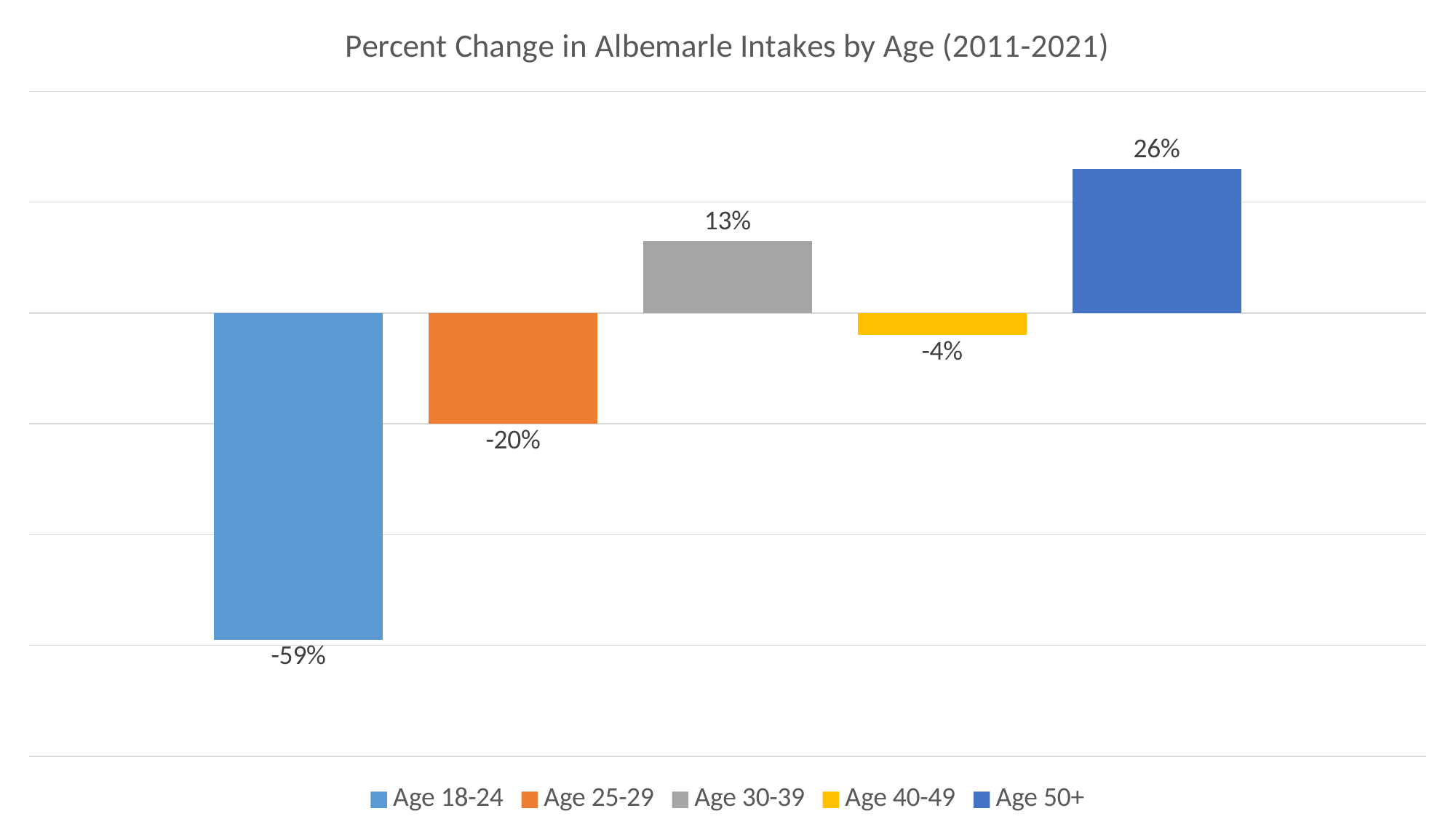
What is the percent change in Albemarle intakes for Age 18-24? -59% Which age group has the lowest percent change in intakes? Age 18-24 What is the difference between the percent change for Age 50+ and Age 30-39? 13 percentage points Which has a larger percent change, Age 25-29 or Age 40-49? Age 40-49 How many entries does the legend list? 5 Which age group has the highest percent change in intakes? Age 50+ What is the percent change in Albemarle intakes for Age 40-49? -4% What is the percent change in Albemarle intakes for Age 30-39? 13% What is the percent change in Albemarle intakes for Age 50+? 26% How many age groups are shown in the chart? 5 What type of chart is shown on the slide? Bar chart What is the title of the chart? Percent Change in Albemarle Intakes by Age (2011-2021)